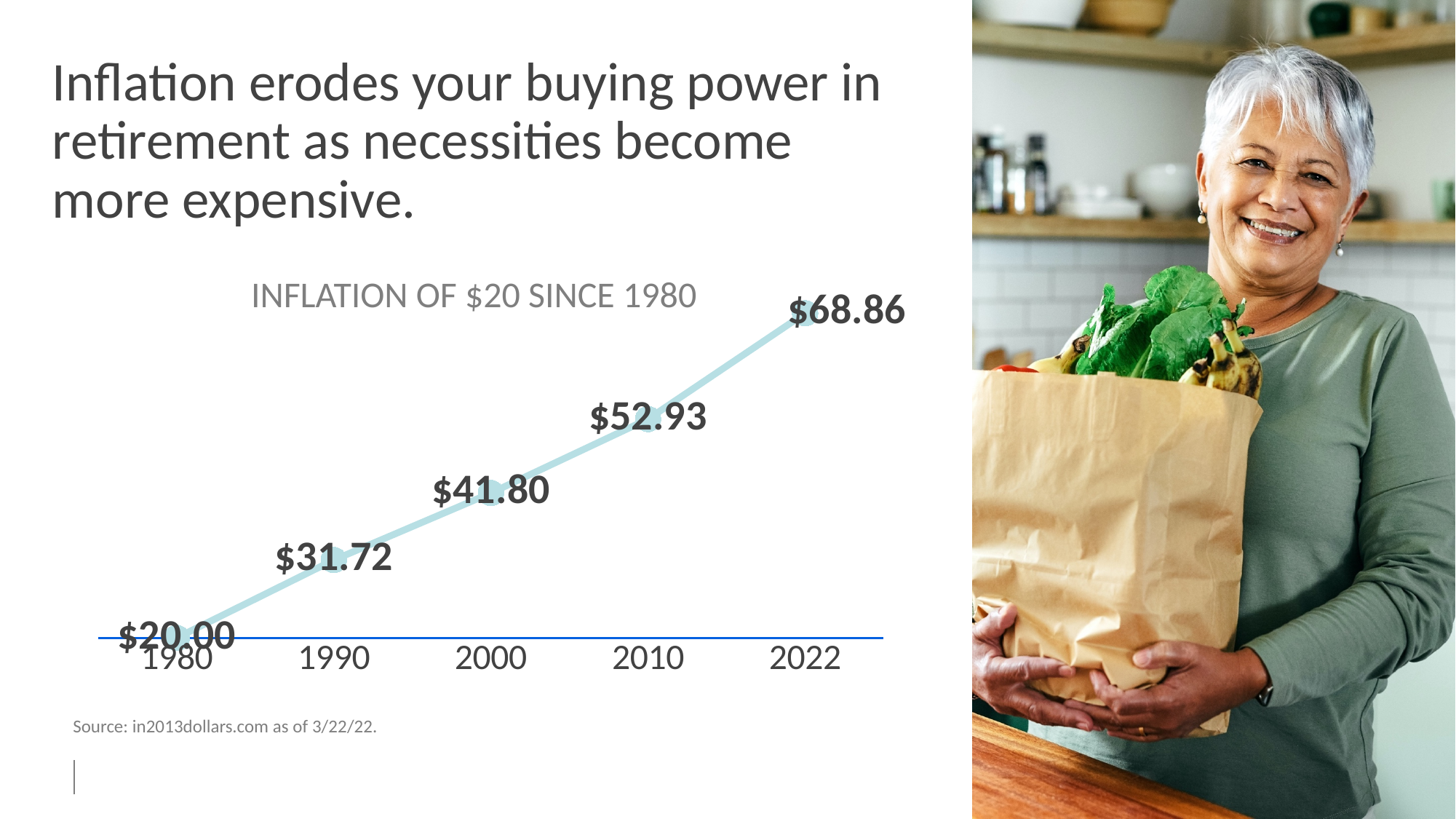
What kind of chart is shown on the slide? line chart What is the value shown for 2022 in the chart? $68.86 What is the difference between the 2010 value and the 2000 value? $11.13 Do the values rise or fall from 1980 to 2022? rise What is the difference between the 2022 value and the 1980 value? $48.86 What is the value shown for 2000 in the chart? $41.80 What is the value shown for 1990 in the chart? $31.72 Which is larger, the value for 1990 or the value for 2000? 2000 What is the value shown for 2010 in the chart? $52.93 How many data points are plotted in the chart? 5 Which year has the highest value in the chart? 2022 Which year has the lowest value in the chart? 1980